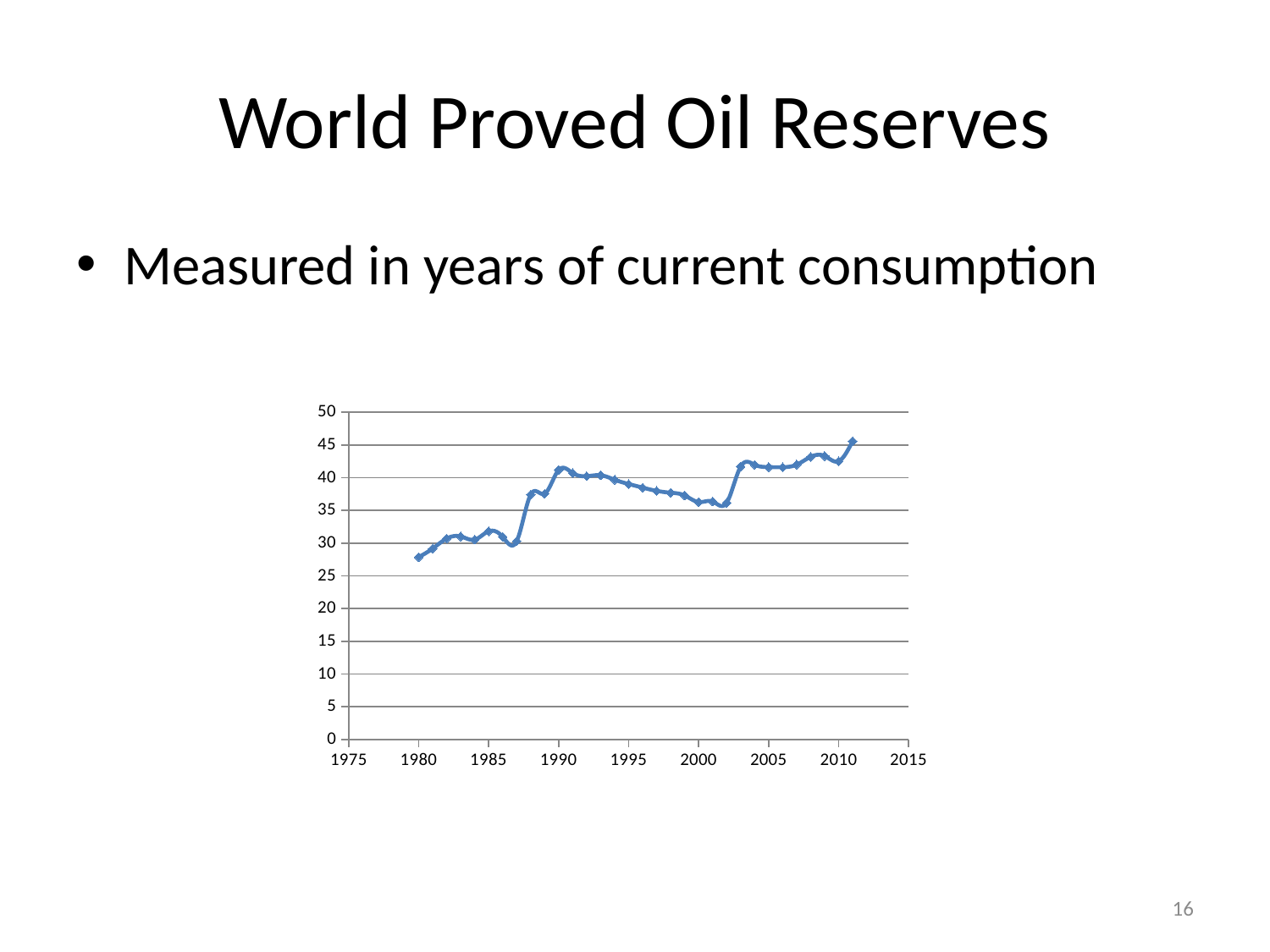
Is the value for 1980 greater or less than 30? less Is the value for 2011 greater or less than 40? greater Which is larger, the value for 2011 or the value for 2000? 2011 What kind of chart is shown on the slide? line chart Overall, do the values rise or fall from 1980 to 2011? rise Which year has the lowest value on the chart? 1980 Which year has the highest value on the chart? 2011 Between 1990 and 2002, do the values rise or fall? fall In what unit are the reserves measured, according to the slide? years of current consumption Is the value for 2002 greater or less than 40? less Which is larger, the value for 1990 or the value for 2002? 1990